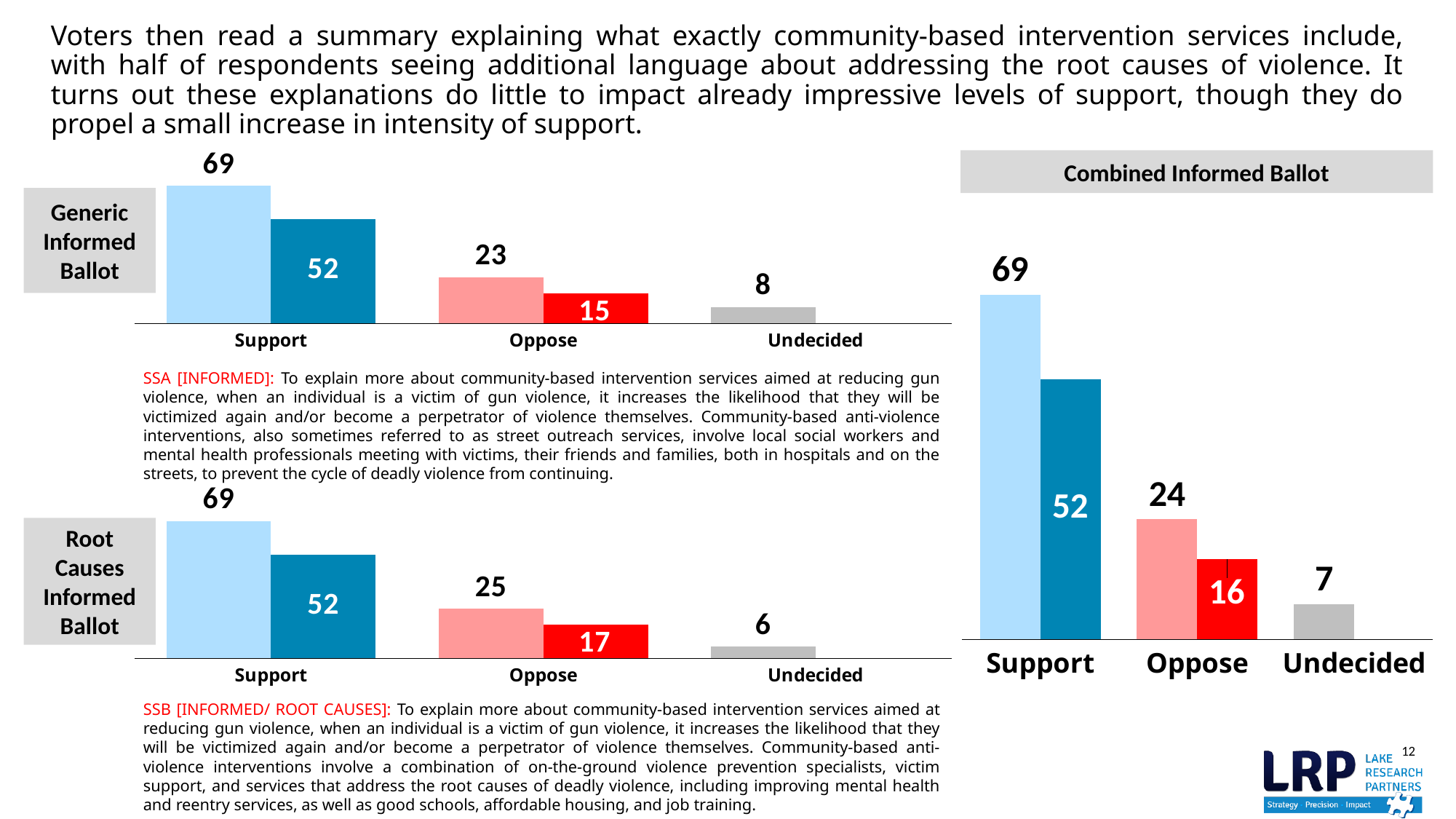
In the Generic Informed Ballot chart, what is the value of the red (darker) Oppose bar? 15 In the Combined Informed Ballot chart, which category has the highest value? Support What type of chart is the Combined Informed Ballot chart? Bar chart In the Generic Informed Ballot chart, what is the value of the tallest Support bar? 69 In the Root Causes Informed Ballot chart, what is the value of the light pink Oppose bar? 25 How many categories are shown on the x axis of the Combined Informed Ballot chart? 3 In the Generic Informed Ballot chart, what is the value for Undecided? 8 In the Root Causes Informed Ballot chart, which category has the lowest value? Undecided In the Combined Informed Ballot chart, what is the value of the red (darker) Oppose bar? 16 In the Root Causes Informed Ballot chart, what is the value for Undecided? 6 In the Combined Informed Ballot chart, what is the difference between the tallest Support bar and the tallest Oppose bar? 45 Which is larger: the Undecided value in the Generic Informed Ballot chart or the Undecided value in the Root Causes Informed Ballot chart? Generic Informed Ballot